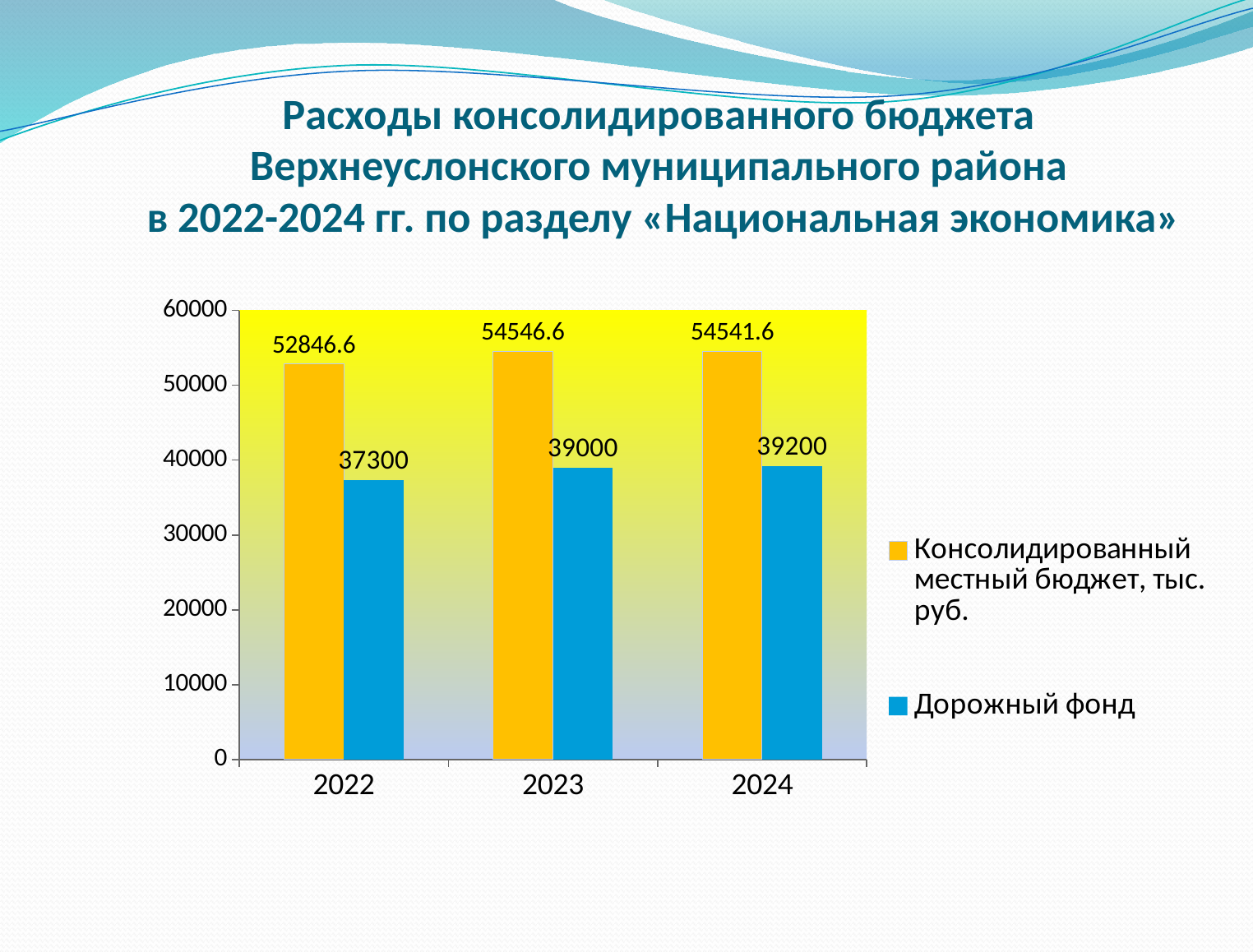
What is the value of the Консолидированный местный бюджет series for 2023? 54546.6 In which year is the Дорожный фонд value lowest? 2022 How many series does the legend list? 2 How many years are shown on the x axis? 3 What is the value of the Дорожный фонд series for 2023? 39000 What is the value of the Дорожный фонд series for 2024? 39200 What kind of chart is shown on the slide? Bar chart In which year is the Консолидированный местный бюджет value lowest? 2022 What is the value of the Консолидированный местный бюджет series for 2022? 52846.6 What is the difference between the Консолидированный местный бюджет and Дорожный фонд values in 2024? 15341.6 Which is larger in 2022: the Консолидированный местный бюджет value or the Дорожный фонд value? Консолидированный местный бюджет By how much did the Дорожный фонд value increase from 2022 to 2024? 1900